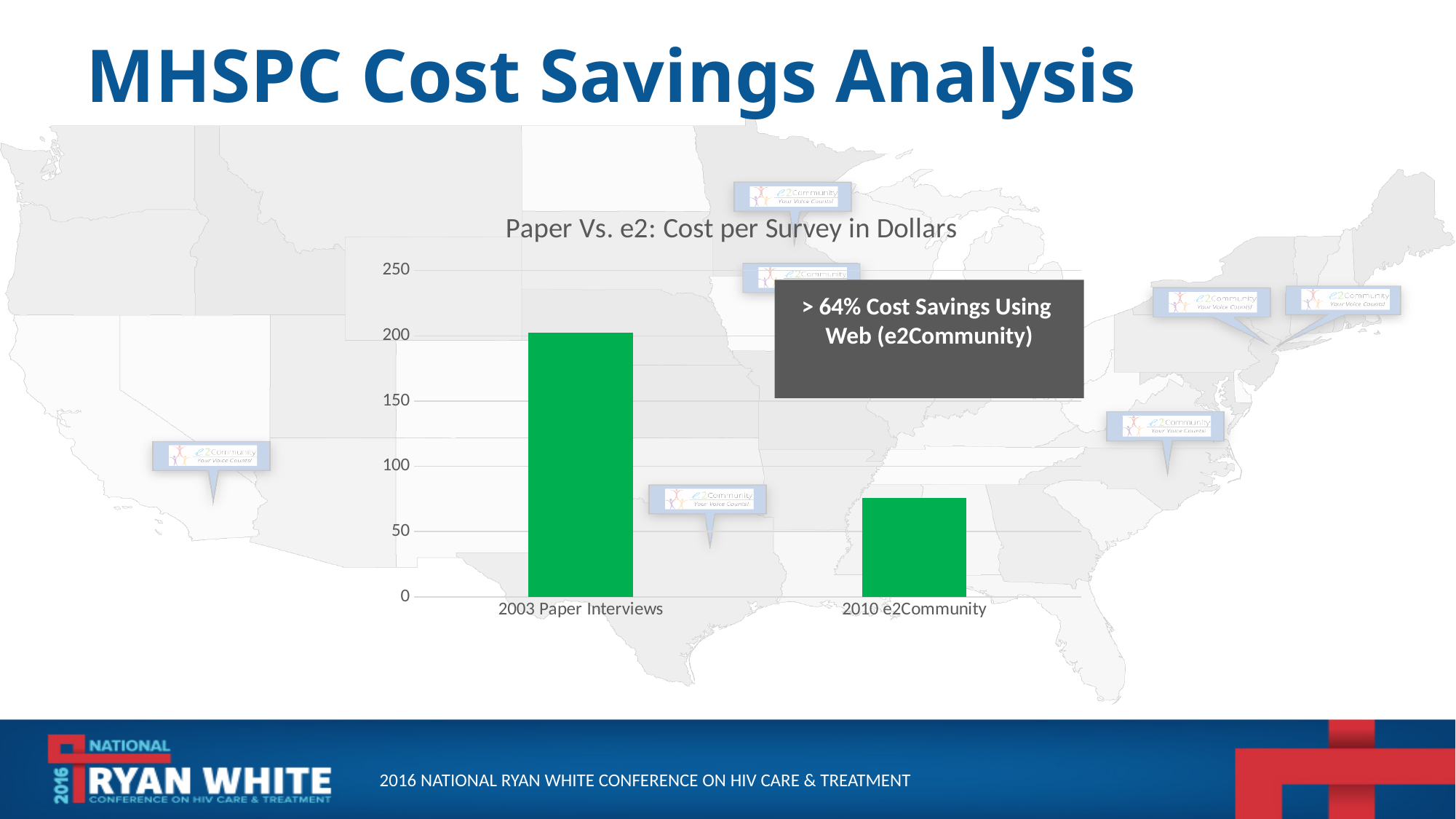
What type of chart is shown on the slide? bar chart What cost savings percentage does the text box on the chart state for using Web (e2Community)? > 64% Is the cost per survey for 2003 Paper Interviews greater or less than 150? greater Which category has the lower cost per survey? 2010 e2Community What is the title of the chart? Paper Vs. e2: Cost per Survey in Dollars Is the cost per survey for 2010 e2Community greater or less than 50? greater Which category has the higher cost per survey? 2003 Paper Interviews How many categories are plotted in the chart? 2 Do the values rise or fall from the left bar to the right bar? fall Is the cost per survey for 2010 e2Community greater or less than 100? less Which is larger: the cost per survey for 2003 Paper Interviews or for 2010 e2Community? 2003 Paper Interviews